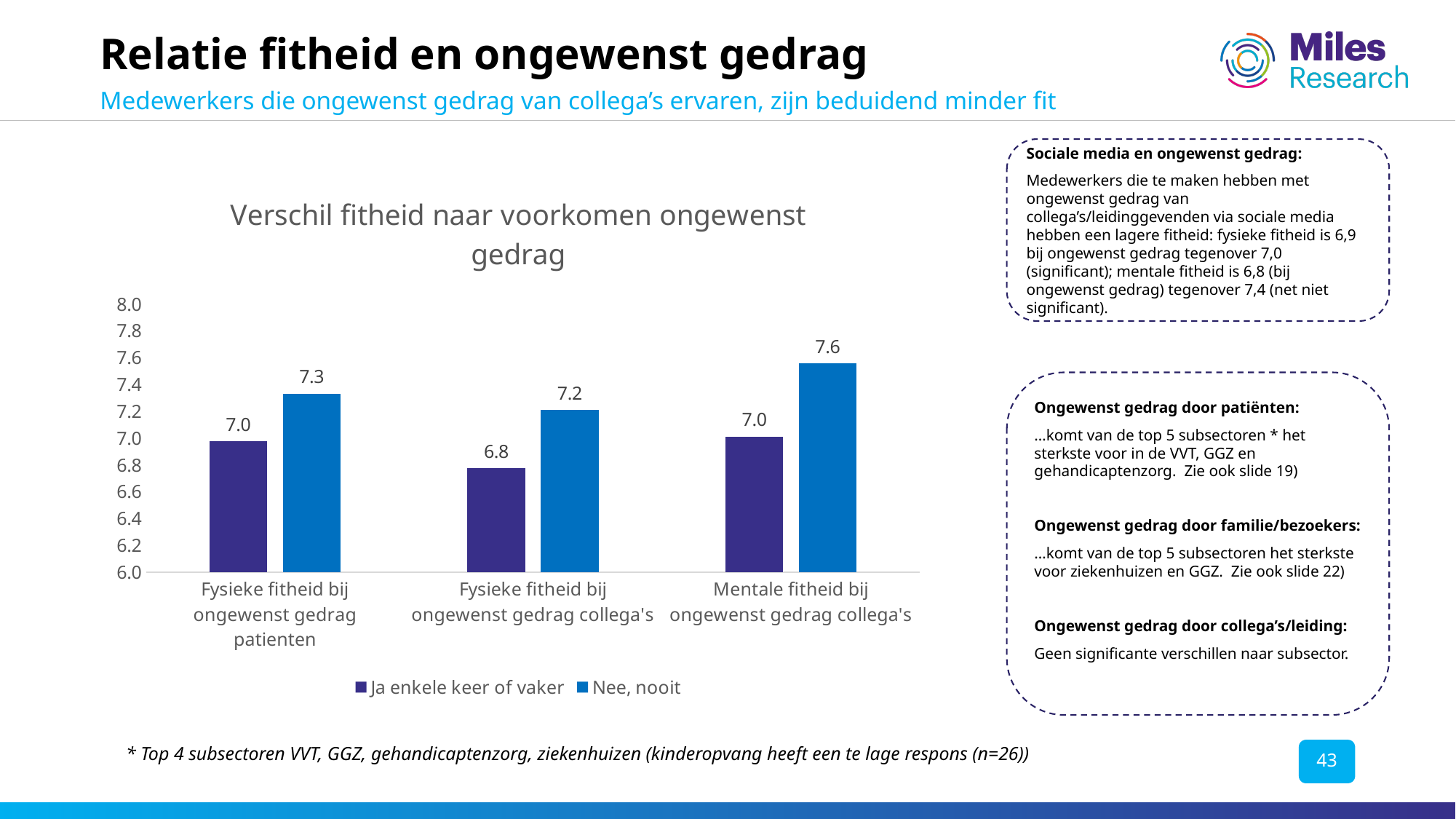
How many categories are shown on the x axis of the chart? 3 What is the value for 'Ja enkele keer of vaker' in the category 'Fysieke fitheid bij ongewenst gedrag patienten'? 7.0 What is the difference between 'Nee, nooit' and 'Ja enkele keer of vaker' in the category 'Fysieke fitheid bij ongewenst gedrag patienten'? 0.3 Which category has the lowest value for the 'Ja enkele keer of vaker' series? Fysieke fitheid bij ongewenst gedrag collega's Which category has the highest value for the 'Nee, nooit' series? Mentale fitheid bij ongewenst gedrag collega's What is the difference between 'Nee, nooit' and 'Ja enkele keer of vaker' in the category 'Mentale fitheid bij ongewenst gedrag collega's'? 0.6 What kind of chart is shown on the slide? Bar chart What is the value for 'Nee, nooit' in the category 'Mentale fitheid bij ongewenst gedrag collega's'? 7.6 What is the title of the chart? Verschil fitheid naar voorkomen ongewenst gedrag What is the value for 'Nee, nooit' in the category 'Fysieke fitheid bij ongewenst gedrag collega's'? 7.2 How many series does the legend list? 2 In the category 'Fysieke fitheid bij ongewenst gedrag collega's', which series has the larger value: 'Ja enkele keer of vaker' or 'Nee, nooit'? Nee, nooit